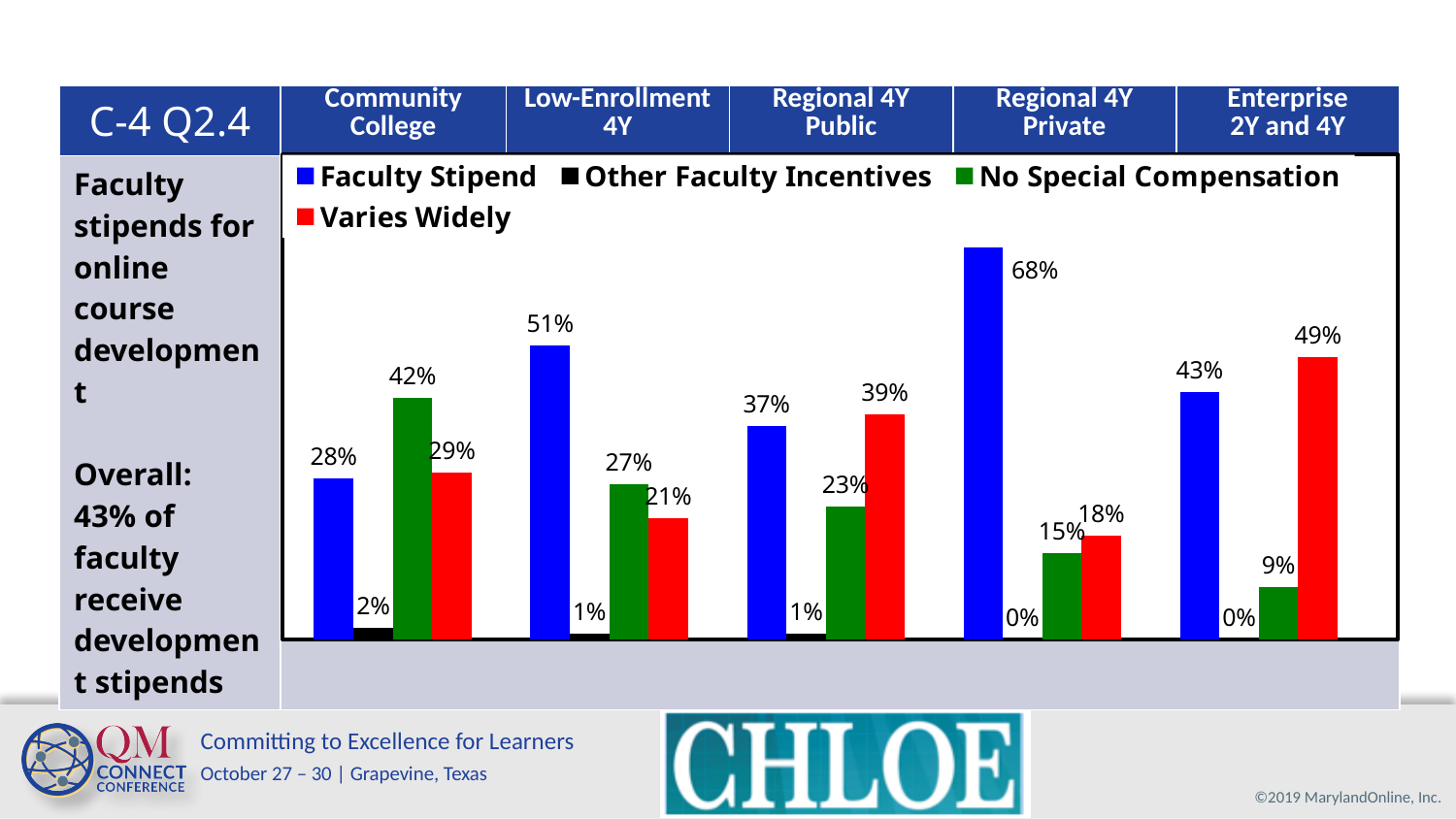
For Regional 4Y Public, which is larger: Faculty Stipend or Varies Widely? Varies Widely How many institution types are shown on the x axis? 5 Which colour represents the Varies Widely series? Red What is the Varies Widely value for Enterprise 2Y and 4Y? 49% What percentage of Regional 4Y Private institutions report Faculty Stipend? 68% Which institution type has the highest Faculty Stipend value? Regional 4Y Private Which institution type has the lowest No Special Compensation value? Enterprise 2Y and 4Y What is the Other Faculty Incentives value for Low-Enrollment 4Y? 1% What is the difference between the Faculty Stipend values for Low-Enrollment 4Y and Community College? 23% How many series does the legend list? 4 What is the value for No Special Compensation at Community College? 42% What kind of chart is shown on the slide? Bar chart